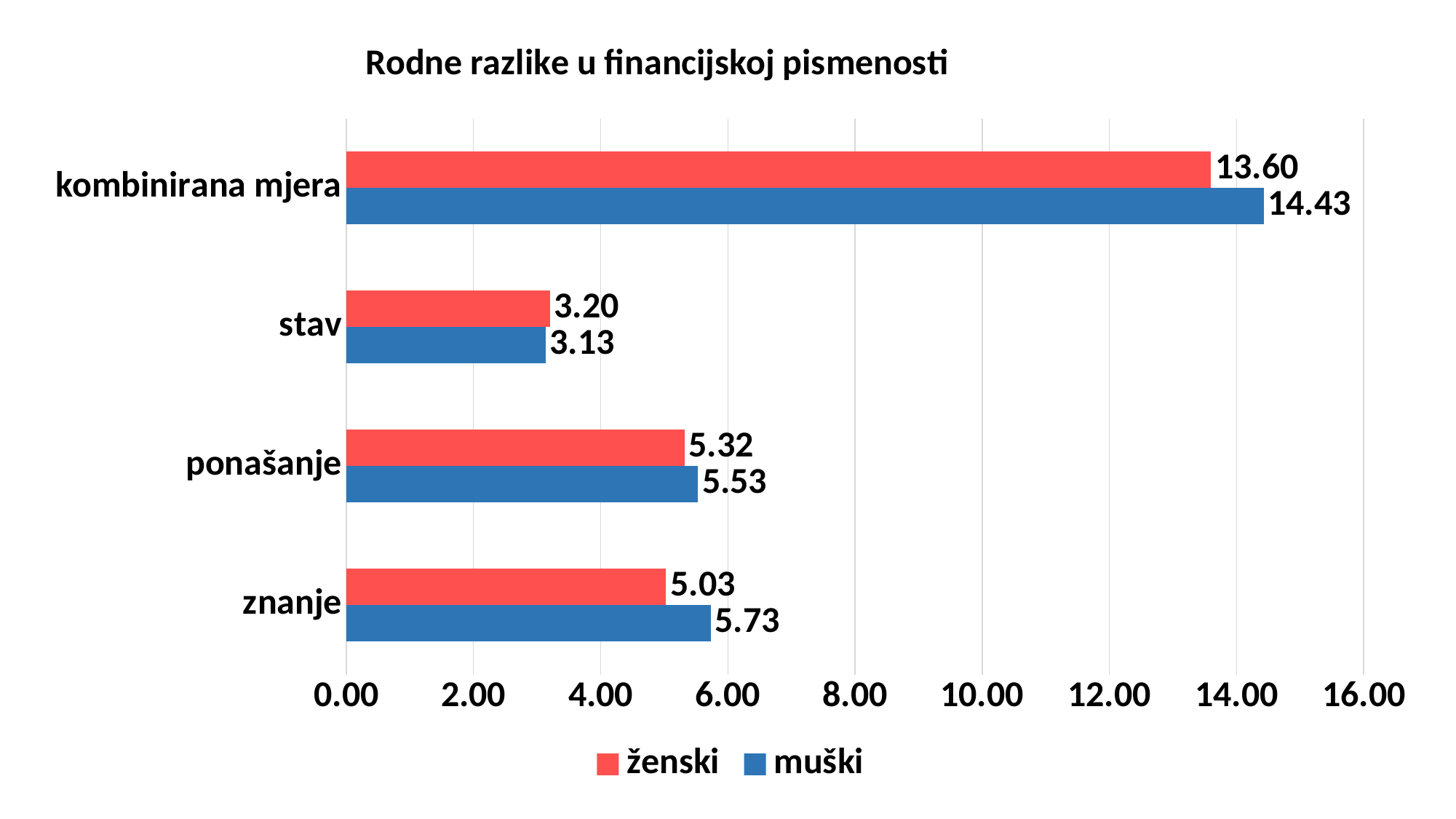
How many categories are shown on the chart? 4 Which category has the highest value for muški? kombinirana mjera What is the value for muški in the znanje category? 5.73 What is the value for ženski in the kombinirana mjera category? 13.60 Is the muški value for kombinirana mjera greater or less than 14.00? greater How many series does the legend list? 2 What is the difference between the muški and ženski values for znanje? 0.70 What is the value for ženski in the stav category? 3.20 Which category has the lowest value for ženski? stav Which is larger for ponašanje, the ženski value or the muški value? muški What is the difference between the muški and ženski values for kombinirana mjera? 0.83 What kind of chart is shown on the slide? bar chart